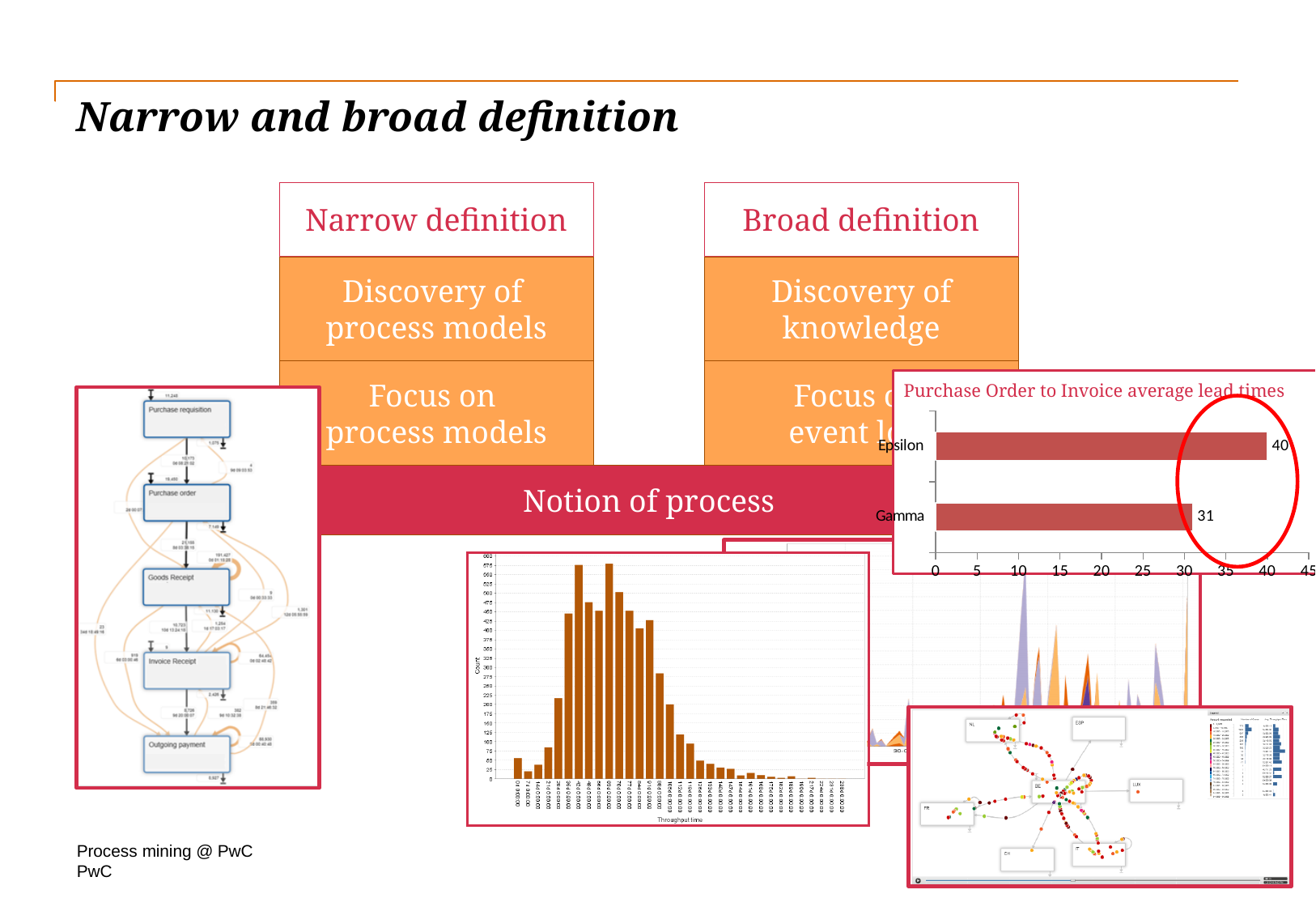
In the 'Purchase Order to Invoice average lead times' chart, is the value for Gamma greater or less than 35? less How many categories are shown in the 'Purchase Order to Invoice average lead times' chart? 2 What kind of chart is the 'Purchase Order to Invoice average lead times' chart? bar chart In the 'Purchase Order to Invoice average lead times' chart, is the value for Epsilon greater or less than 35? greater What kind of chart is the chart at the bottom centre of the slide with the x axis labelled 'Throughput time'? bar chart In the 'Purchase Order to Invoice average lead times' chart, what is the value for Gamma? 31 In the 'Purchase Order to Invoice average lead times' chart, which is larger, the value for Epsilon or the value for Gamma? Epsilon In the 'Purchase Order to Invoice average lead times' chart, what is the difference between the values for Epsilon and Gamma? 9 In the 'Purchase Order to Invoice average lead times' chart, what is the value for Epsilon? 40 In the chart at the bottom centre of the slide with the x axis labelled 'Throughput time', is the tallest bar greater or less than 500? greater In the 'Purchase Order to Invoice average lead times' chart, which category has the highest value? Epsilon In the 'Purchase Order to Invoice average lead times' chart, which category has the lowest value? Gamma